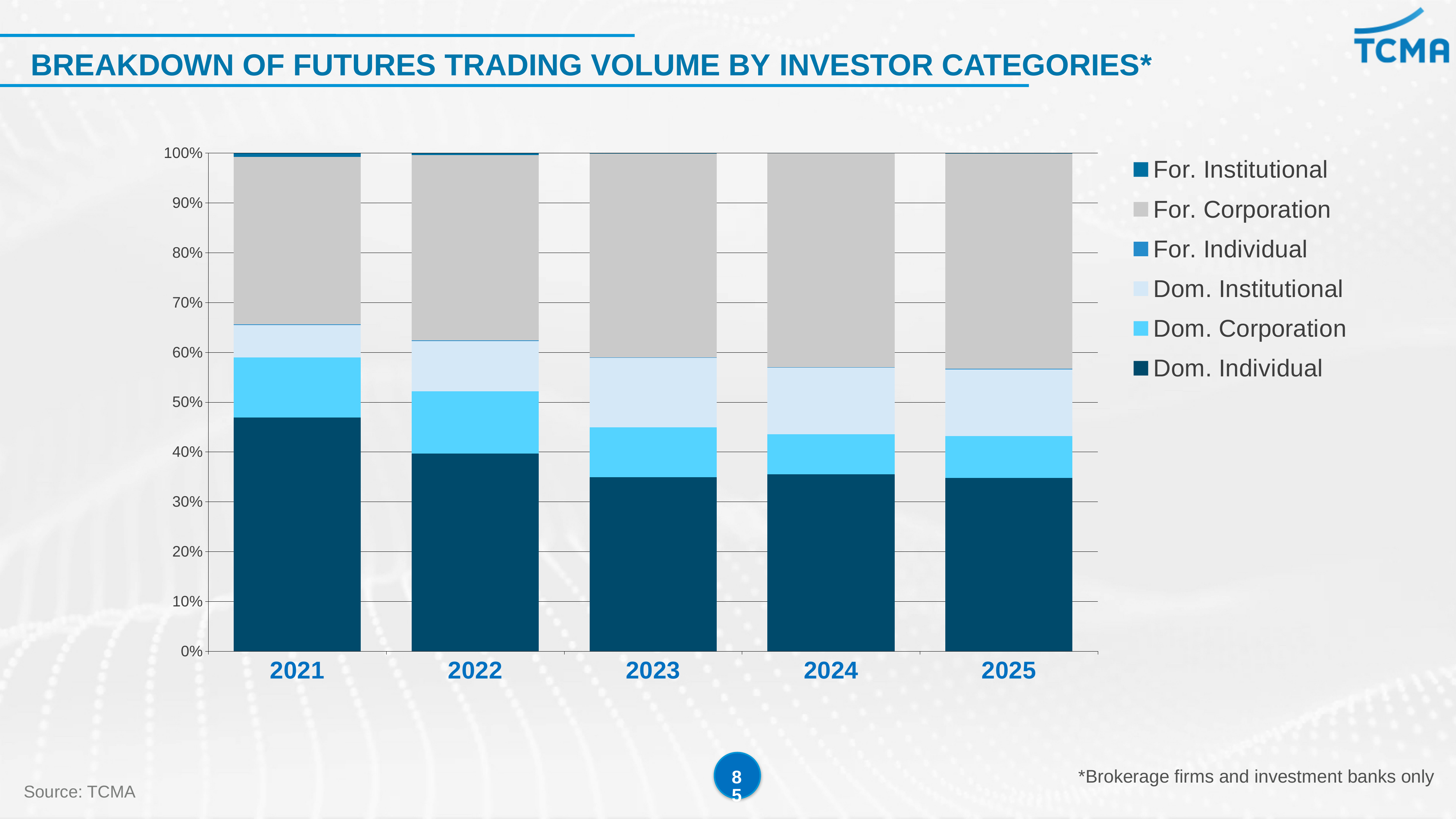
Is the combined share of the three domestic investor categories in 2021 greater or less than 60%? greater Which year has the larger Dom. Individual share, 2021 or 2022? 2021 In which year is the Dom. Individual share the highest? 2021 What kind of chart is shown on the slide? Stacked bar chart Does the Dom. Individual share rise or fall from 2021 to 2023? fall Is the Dom. Individual share in 2021 greater or less than 40%? greater What is the title of the chart on the slide? BREAKDOWN OF FUTURES TRADING VOLUME BY INVESTOR CATEGORIES* Is the combined share of the three domestic investor categories in 2025 greater or less than 60%? less How many investor categories does the legend list? 6 Which investor category is shown at the bottom of each stacked bar? Dom. Individual How many years are shown on the x axis of the chart? 5